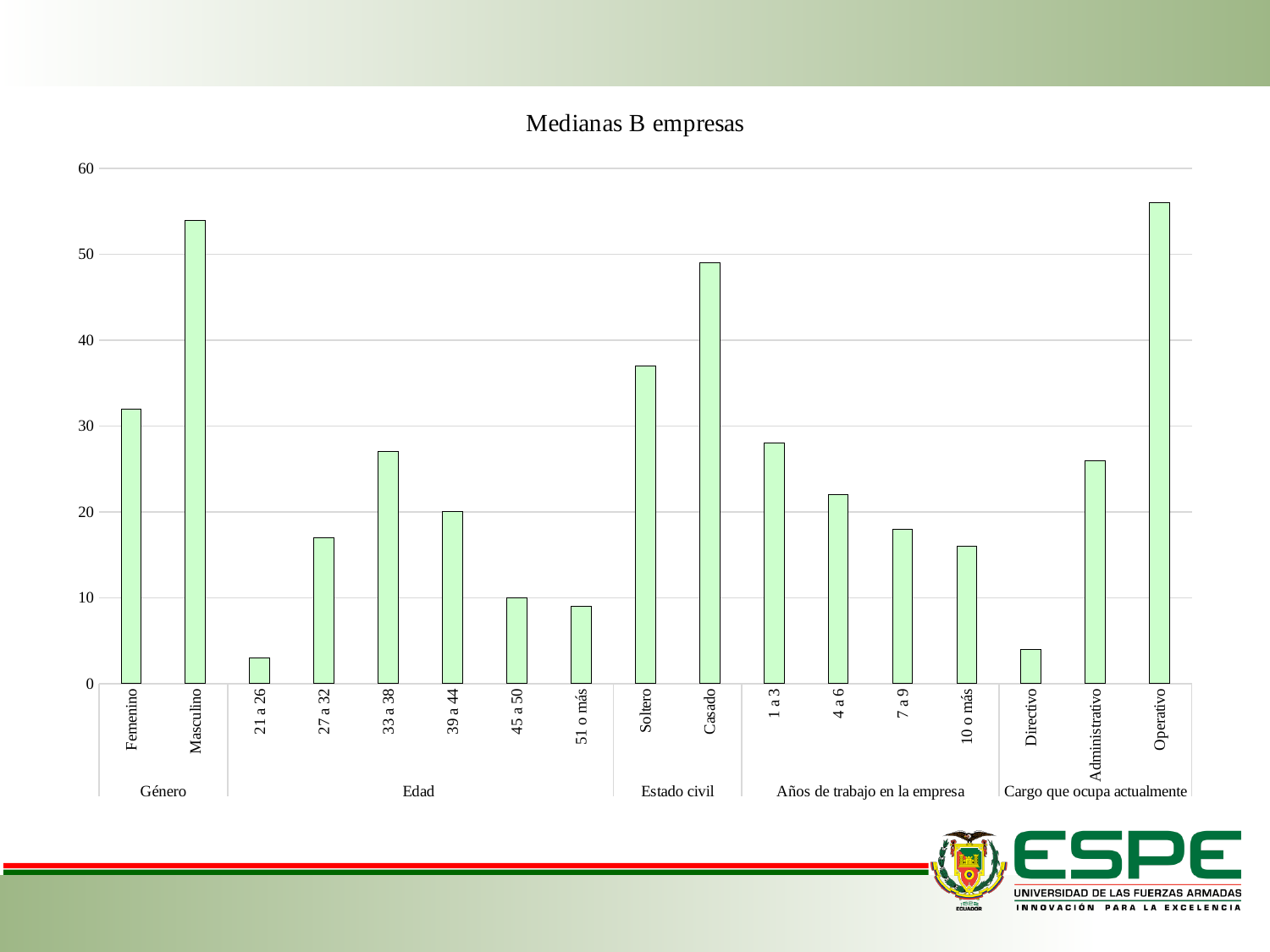
Which is larger, the value for Soltero or the value for Casado? Casado Within the Cargo que ocupa actualmente group, which category has the highest value? Operativo Is the value for 21 a 26 greater or less than 10? less Is the value for Femenino greater or less than 30? greater How many category groups are shown along the x axis (Género, Edad, etc.)? 5 Do the values rise or fall across the Años de trabajo en la empresa group from 1 a 3 to 10 o más? fall How many bars are plotted in the chart? 17 Within the Edad group, which age range has the lowest value? 21 a 26 Is the value for Casado greater or less than 40? greater What kind of chart is shown on the slide? bar chart What is the title of the chart? Medianas B empresas